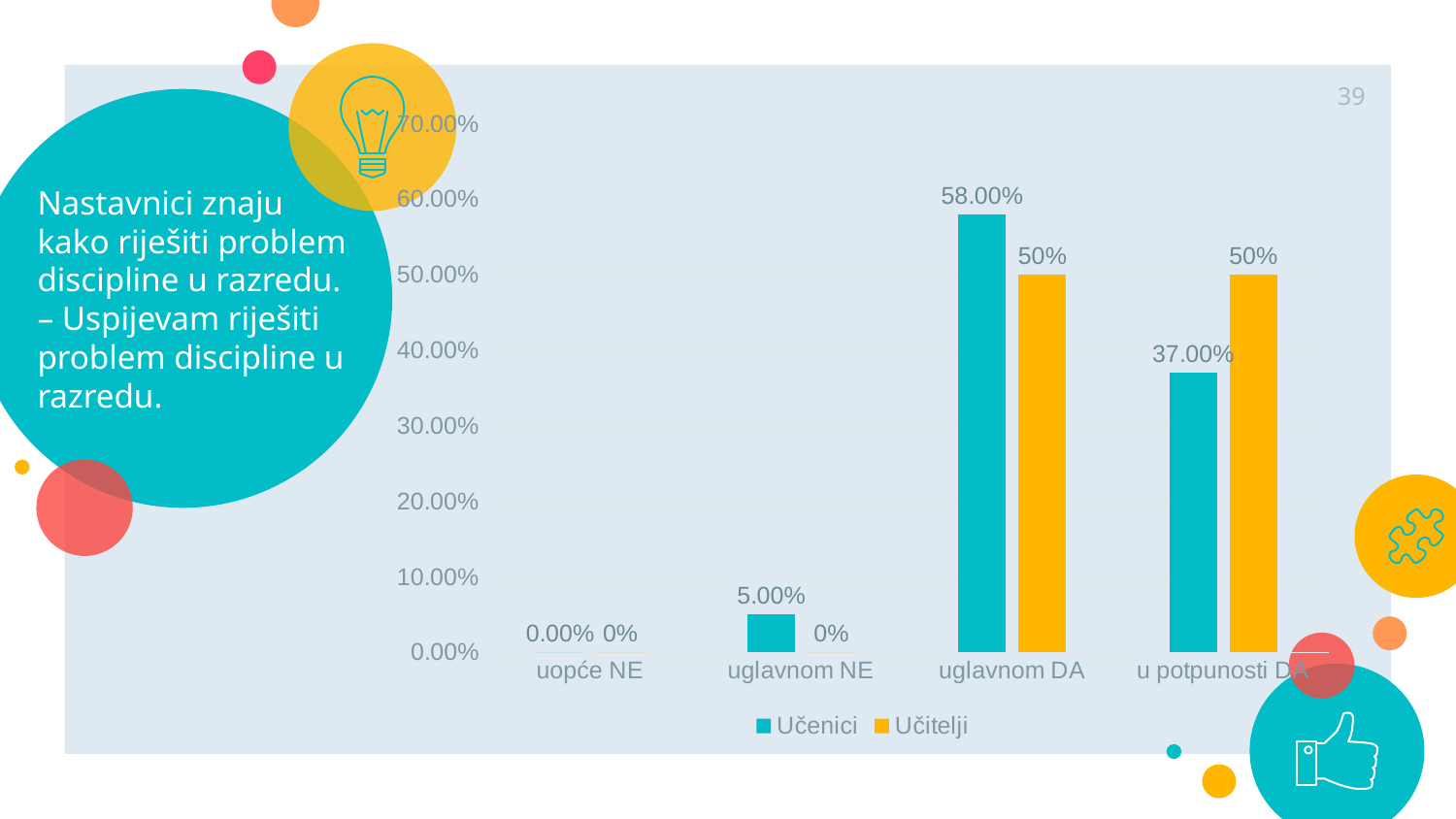
Which category has the highest value for Učenici? uglavnom DA What kind of chart is shown on the slide? bar chart What colour are the bars for the Učitelji series? orange What is the value for Učenici in the uglavnom DA category? 58.00% How many categories are shown on the x axis? 4 Which category has the lowest value for Učenici? uopće NE What is the difference between the Učenici and Učitelji values in the uglavnom DA category? 8.00% What is the value for Učenici in the uglavnom NE category? 5.00% What is the value for Učitelji in the u potpunosti DA category? 50% What is the value for Učenici in the u potpunosti DA category? 37.00% In the u potpunosti DA category, which series has the larger value, Učenici or Učitelji? Učitelji How many series does the legend list? 2